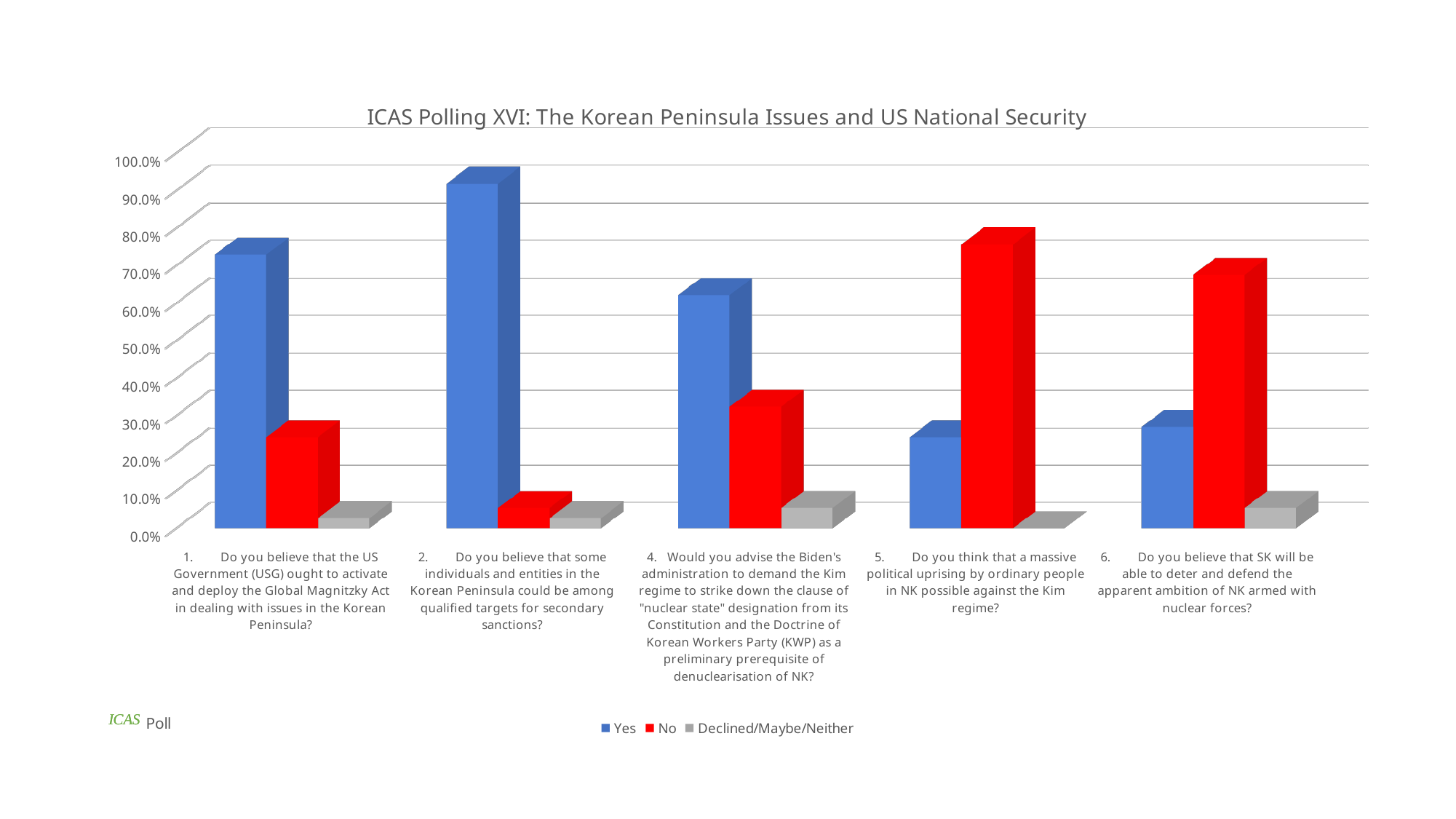
How many poll questions (categories) are plotted on the x axis? 5 Which poll question has the highest 'No' value? 5. Do you think that a massive political uprising by ordinary people in NK possible against the Kim regime? Which poll question has the highest 'Yes' value? 2. Do you believe that some individuals and entities in the Korean Peninsula could be among qualified targets for secondary sanctions? What kind of chart is shown on the slide? Bar chart For question 1 (Global Magnitzky Act), which is larger, the 'Yes' value or the 'No' value? Yes Which poll question has the lowest 'Yes' value? 5. Do you think that a massive political uprising by ordinary people in NK possible against the Kim regime? Is the 'Yes' value for question 2 (secondary sanctions) greater or less than 80.0%? greater Is the 'No' value for question 5 (political uprising in NK) greater or less than 60.0%? greater What is the title of the chart? ICAS Polling XVI: The Korean Peninsula Issues and US National Security For question 6 (SK able to deter and defend), which is larger, the 'Yes' value or the 'No' value? No How many series does the legend list? 3 Is the 'No' value for question 1 (Global Magnitzky Act) greater or less than 40.0%? less